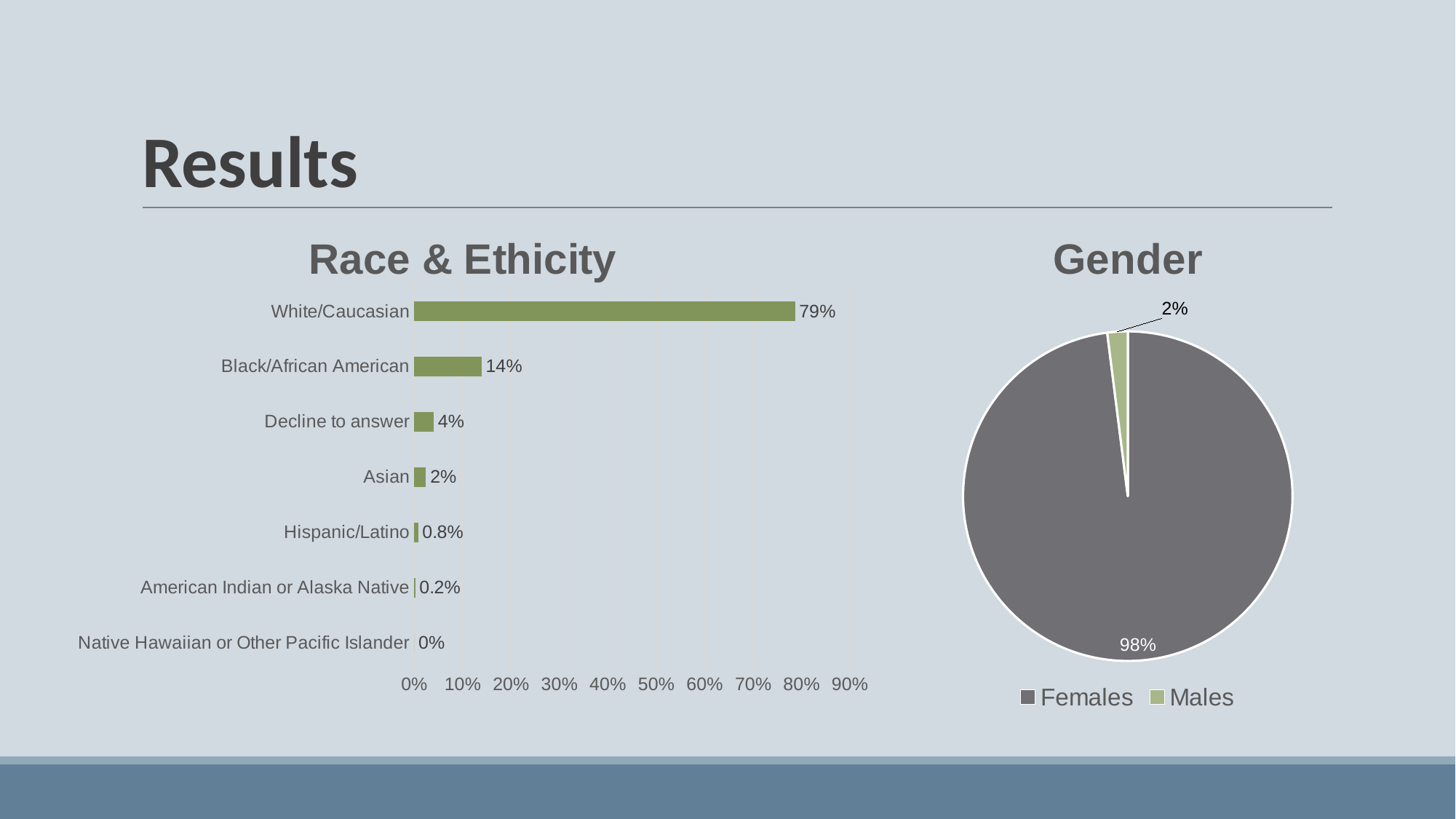
How many categories are shown in the Race & Ethicity chart? 7 How many entries does the legend of the Gender chart list? 2 In the Race & Ethicity chart, which category has the lowest value? Native Hawaiian or Other Pacific Islander In the Race & Ethicity chart, what is the value for White/Caucasian? 79% In the Gender chart, what share of the pie is Females? 98% In the Race & Ethicity chart, which is larger, the value for Decline to answer or the value for Asian? Decline to answer What kind of chart is the Race & Ethicity chart? Bar chart In the Race & Ethicity chart, what is the value for Hispanic/Latino? 0.8% In the Gender chart, what share of the pie is Males? 2% In the Race & Ethicity chart, what is the difference between the values for White/Caucasian and Black/African American? 65% In the Race & Ethicity chart, which category has the highest value? White/Caucasian In the Race & Ethicity chart, what is the value for Black/African American? 14%